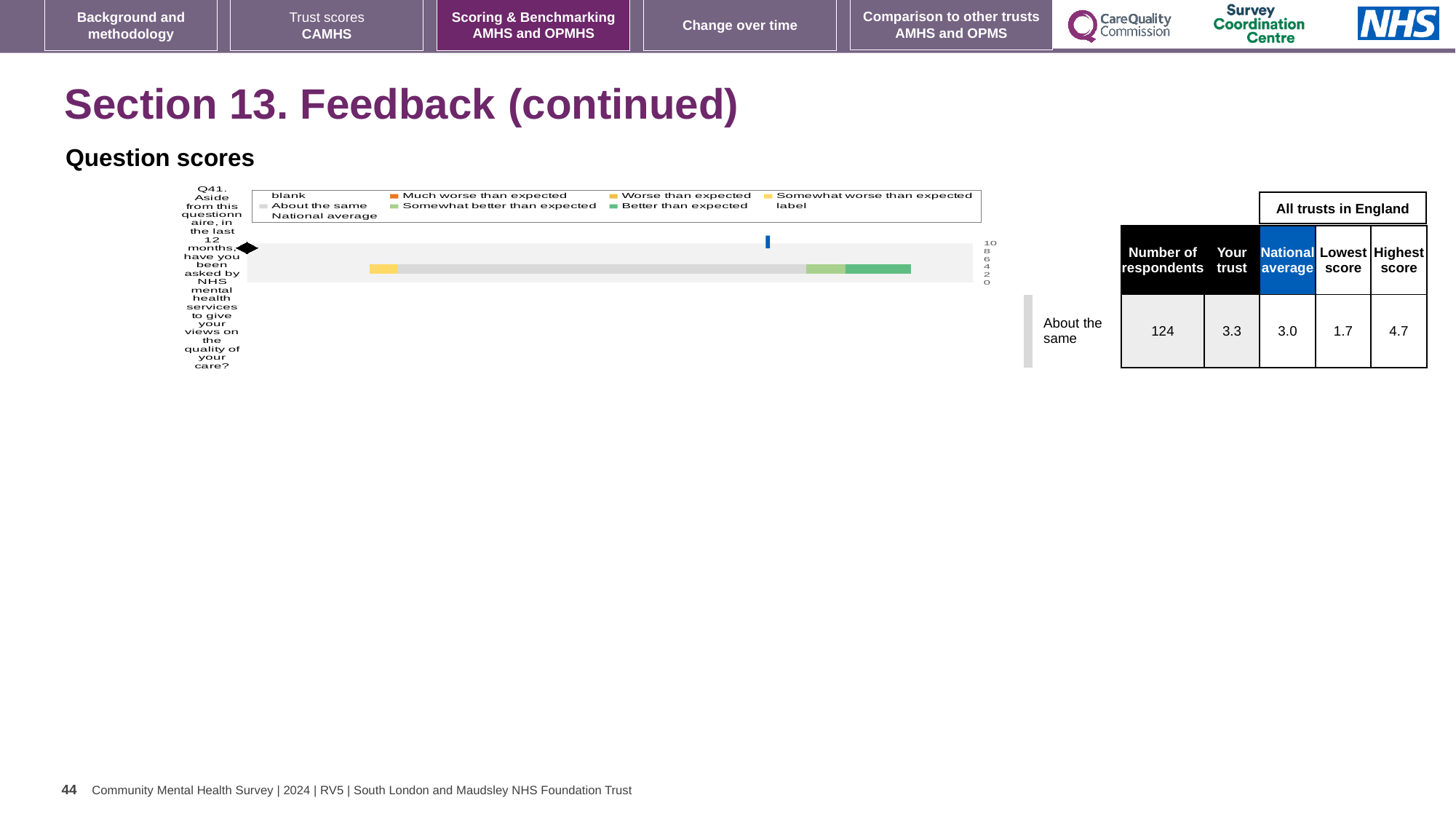
According to the table next to the chart, what is the national average score for Q41? 3.0 According to the table next to the chart, what is the lowest score among all trusts in England for Q41? 1.7 How many questions (categories) are plotted in the chart? 1 What is the difference between the highest score (4.7) and the lowest score (1.7) for Q41 in the table? 3.0 Which question number is plotted in the chart? Q41 According to the table next to the chart, what is the highest score among all trusts in England for Q41? 4.7 According to the table next to the chart, how many respondents answered Q41? 124 Is the trust's score for Q41 (3.3) larger or smaller than the national average (3.0)? larger How many entries does the chart legend list? 9 What kind of chart is shown on the slide? bar chart Which legend entry is shown in orange in the chart? Much worse than expected According to the table next to the chart, what is the 'Your trust' score for Q41? 3.3